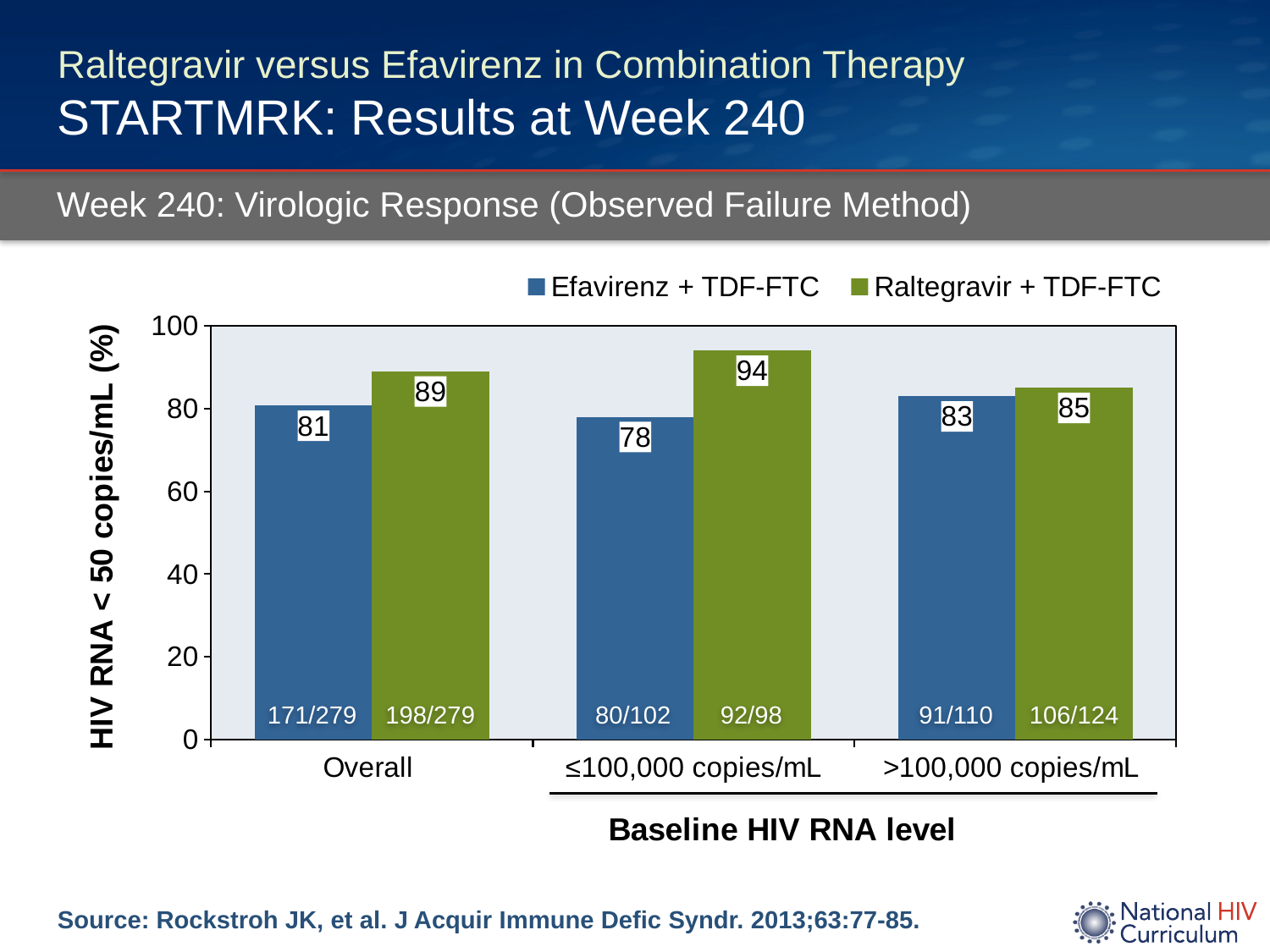
How many categories are shown on the x axis? 3 What is the value for Efavirenz + TDF-FTC in the Overall category? 81 What is the label of the y axis? HIV RNA < 50 copies/mL (%) What is the value for Raltegravir + TDF-FTC in the ≤100,000 copies/mL category? 94 What kind of chart is shown on the slide? Bar chart Which category has the lowest value for Efavirenz + TDF-FTC? ≤100,000 copies/mL What fraction is printed on the Raltegravir + TDF-FTC bar in the Overall category? 198/279 What is the difference between the Raltegravir + TDF-FTC and Efavirenz + TDF-FTC values in the ≤100,000 copies/mL category? 16 In the Overall category, which series has the larger value, Efavirenz + TDF-FTC or Raltegravir + TDF-FTC? Raltegravir + TDF-FTC How many series does the legend list? 2 Which category has the highest value for Raltegravir + TDF-FTC? ≤100,000 copies/mL What is the value for Raltegravir + TDF-FTC in the >100,000 copies/mL category? 85